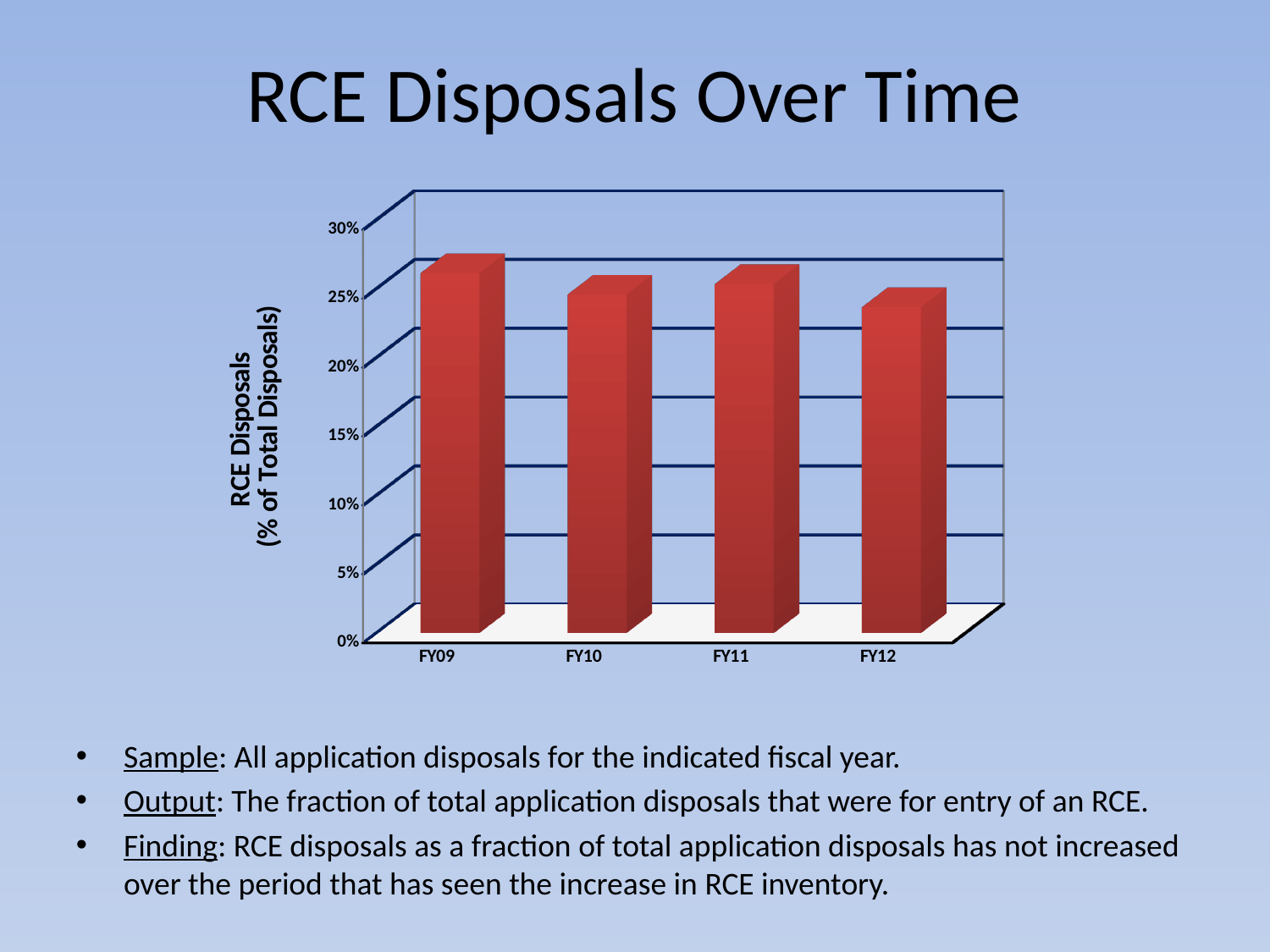
What is the title of the chart on the slide? RCE Disposals Over Time Is the value for FY12 greater or less than 20%? greater Which fiscal year has the lowest RCE disposals percentage? FY12 Do the values generally rise or fall from FY09 to FY12? fall How many fiscal years are plotted on the chart? 4 Is the value for FY10 greater or less than 30%? less Is the value for FY11 greater or less than 20%? greater What kind of chart is shown on the slide? bar chart Which fiscal year has the highest RCE disposals percentage? FY09 What is the label on the vertical axis of the chart? RCE Disposals (% of Total Disposals) Which is larger, the value for FY09 or the value for FY12? FY09